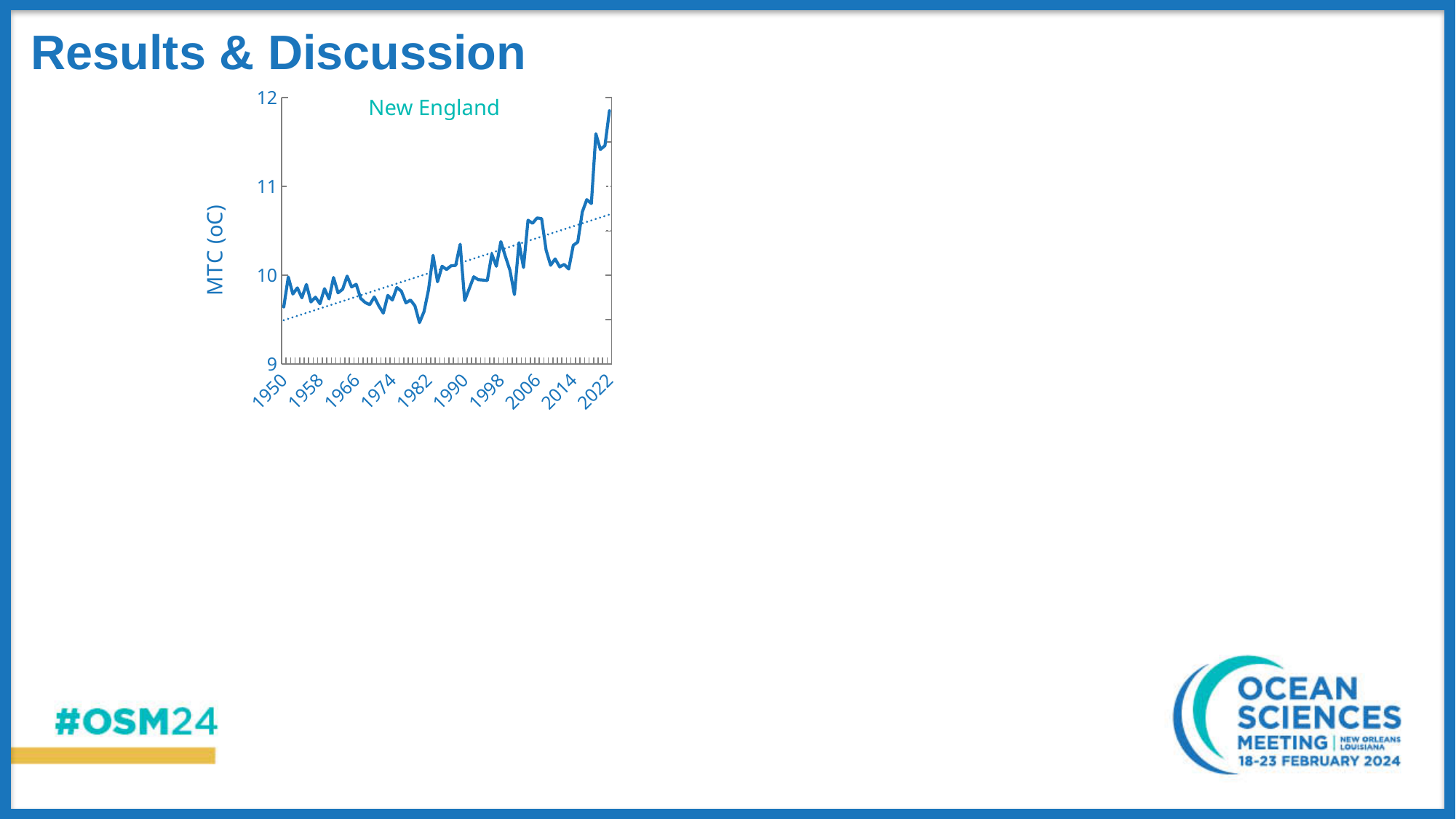
Which is larger, the value for 2022 or the value for 1950? 2022 What is the title of the chart? New England What kind of chart is shown on the slide? line chart What is the label of the y-axis? MTC (oC) Is the value for 2006 greater or less than 10? greater Is the value for 1950 greater or less than 10? less Is the value for 2022 greater or less than 11? greater Which labeled year has the highest value on the line? 2022 What is the first year labeled on the x-axis? 1950 Overall, do the values rise or fall from 1950 to 2022? rise